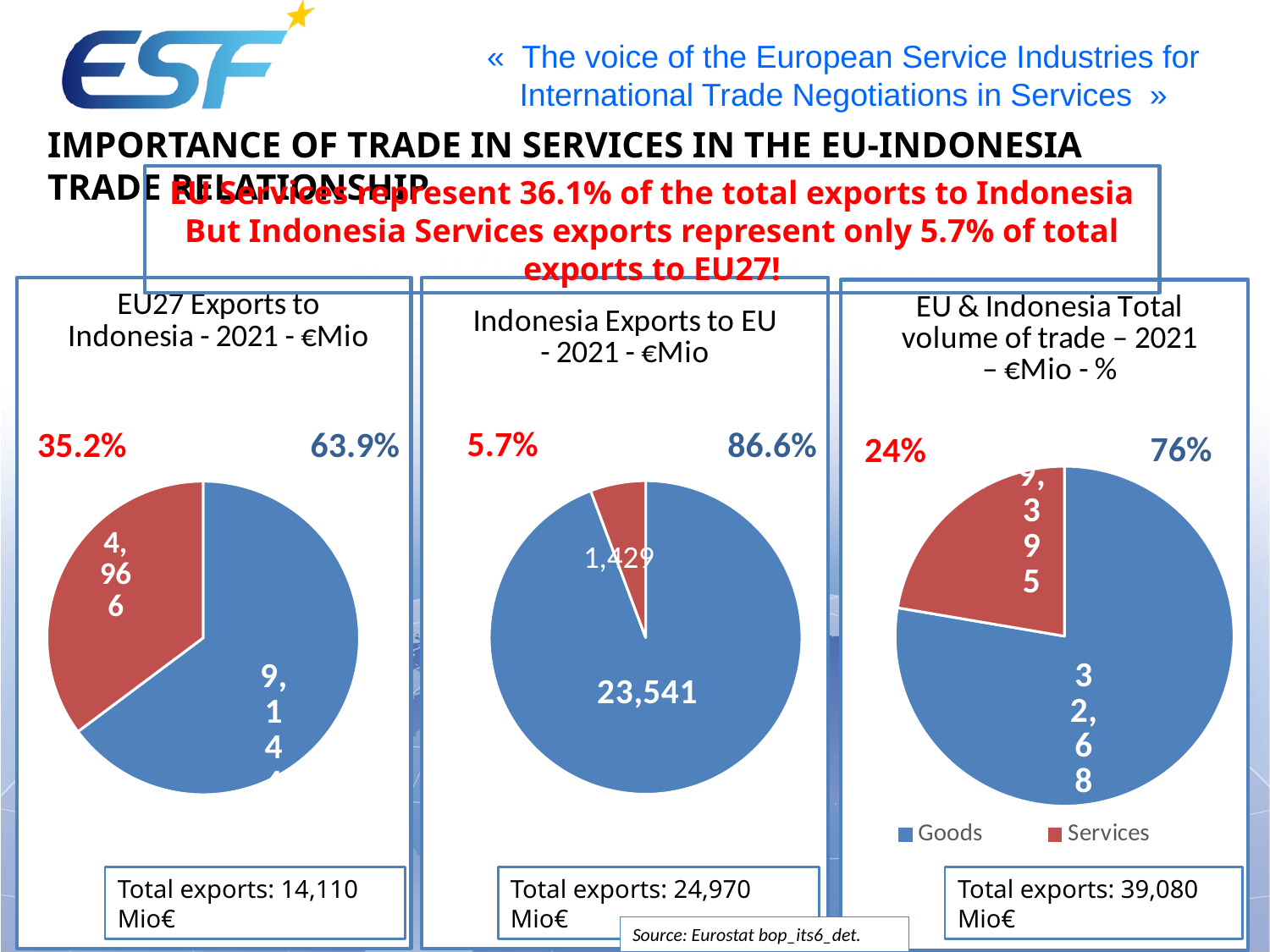
In the 'Indonesia Exports to EU - 2021' chart, what is the value for Services? 1,429 In the 'Indonesia Exports to EU - 2021' chart, what is the value for Goods? 23,541 What are the two entries listed in the legend under the 'EU & Indonesia Total volume of trade' chart? Goods and Services In the 'EU & Indonesia Total volume of trade' chart, which category has the largest slice? Goods In the 'Indonesia Exports to EU - 2021' chart, what share of the pie is Goods? 86.6% In the 'EU27 Exports to Indonesia - 2021' chart, which is larger, Goods or Services? Goods How many slices does each pie chart on the slide have? 2 In the 'Indonesia Exports to EU - 2021' chart, what is the difference between the Goods value and the Services value? 22,112 What kind of chart is used on this slide to show EU27 Exports to Indonesia? Pie chart In the 'EU27 Exports to Indonesia - 2021' chart, what share of the pie is Services? 35.2% In the 'EU & Indonesia Total volume of trade' chart, what share of the pie is Services? 24% In the 'EU27 Exports to Indonesia - 2021' chart, what is the value for Services? 4,966